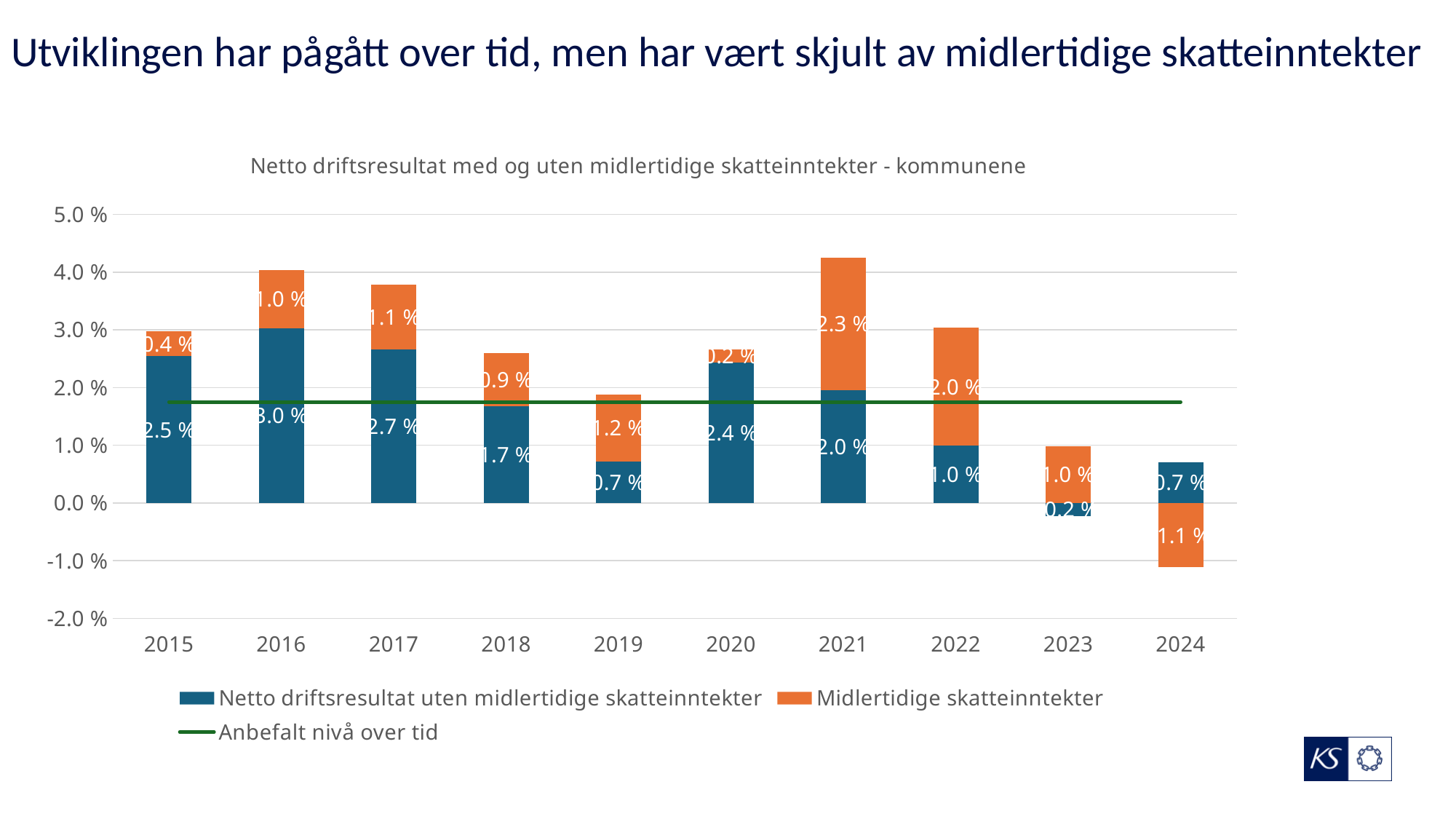
How many series does the legend list? 3 What is the value of Midlertidige skatteinntekter for 2021? 2.3 % For 2021, how much larger is Midlertidige skatteinntekter than Netto driftsresultat uten midlertidige skatteinntekter? 0.3 % What is the total of the stacked bar for 2016? 4.0 % What is the value of Netto driftsresultat uten midlertidige skatteinntekter for 2015? 2.5 % What is the title of the chart? Netto driftsresultat med og uten midlertidige skatteinntekter - kommunene How many years are shown on the x axis? 10 In which year is Netto driftsresultat uten midlertidige skatteinntekter lowest? 2023 What kind of chart is shown on the slide? Stacked bar chart with a line Is the total height of the stacked bar for 2021 greater or less than 4.0 %? greater In which year is Netto driftsresultat uten midlertidige skatteinntekter highest? 2016 Which year has the larger value for Netto driftsresultat uten midlertidige skatteinntekter, 2017 or 2020? 2017